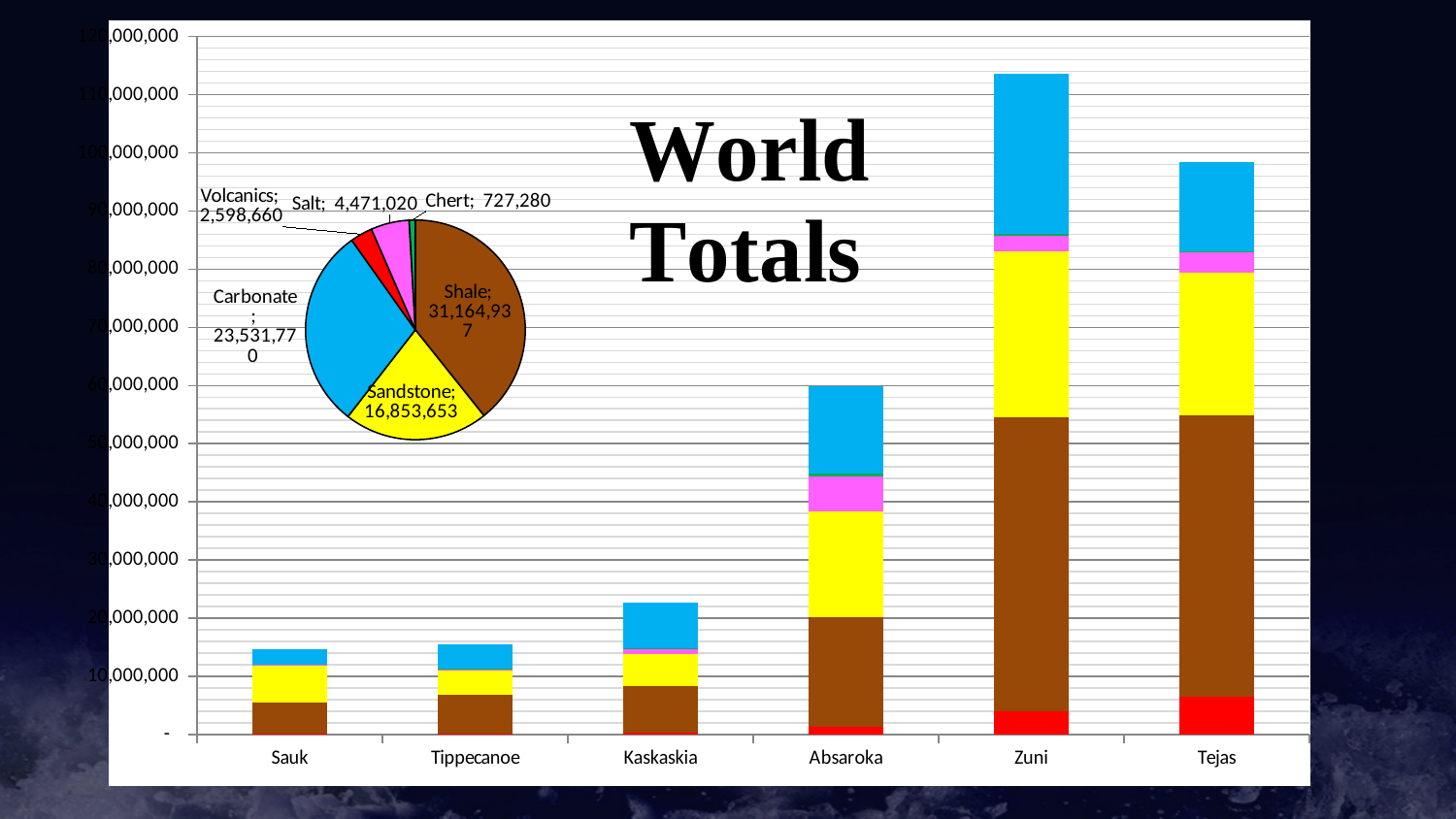
In the World Totals pie chart, which slice has the largest value? Shale In the World Totals pie chart, what is the difference between the Shale and Sandstone values? 14,311,284 What kind of chart is the large chart with categories Sauk through Tejas? Stacked bar chart In the stacked bar chart, which category has the tallest bar? Zuni In the World Totals pie chart, what is the value for Carbonate? 23,531,770 In the stacked bar chart, how many categories are shown on the x axis? 6 In the World Totals pie chart, which slice has the smallest value? Chert In the World Totals pie chart, what is the value for Shale? 31,164,937 In the World Totals pie chart, which is larger, Salt or Volcanics? Salt In the World Totals pie chart, what is the value for Salt? 4,471,020 How many slices does the World Totals pie chart have? 6 In the stacked bar chart, is the total for Tejas greater or less than 100,000,000? less